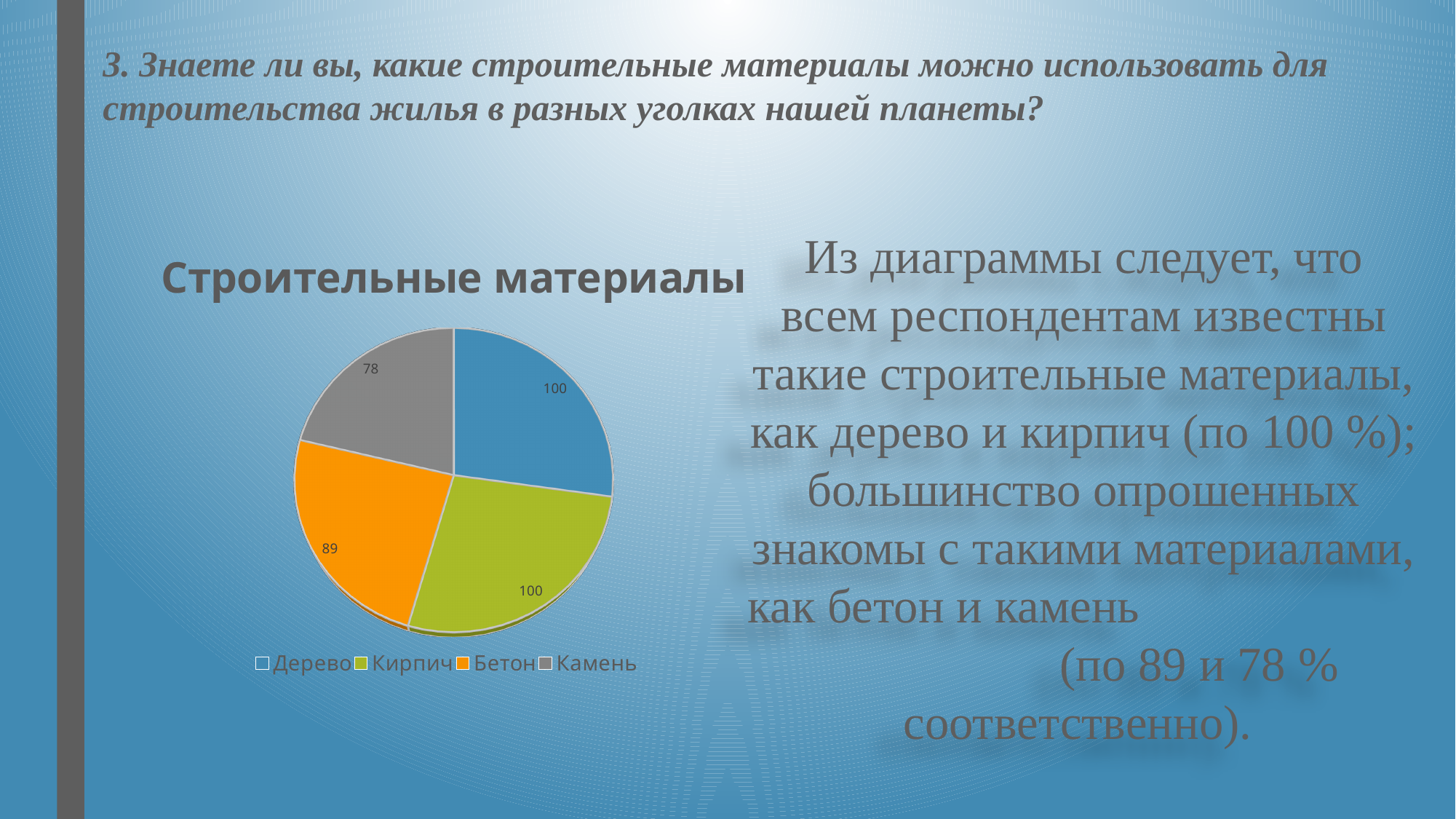
Which category has the smallest slice in the pie chart? Камень What kind of chart is shown on the slide? Pie chart Which category is shown in orange in the pie chart? Бетон How many categories are shown in the pie chart? 4 What value is shown for Дерево in the pie chart? 100 What value is shown for Камень in the pie chart? 78 What value is shown for Бетон in the pie chart? 89 What value is shown for Кирпич in the pie chart? 100 What is the difference between the values for Дерево and Камень? 22 What is the difference between the values for Бетон and Камень? 11 Which has the larger value, Бетон or Камень? Бетон What is the title of the chart? Строительные материалы